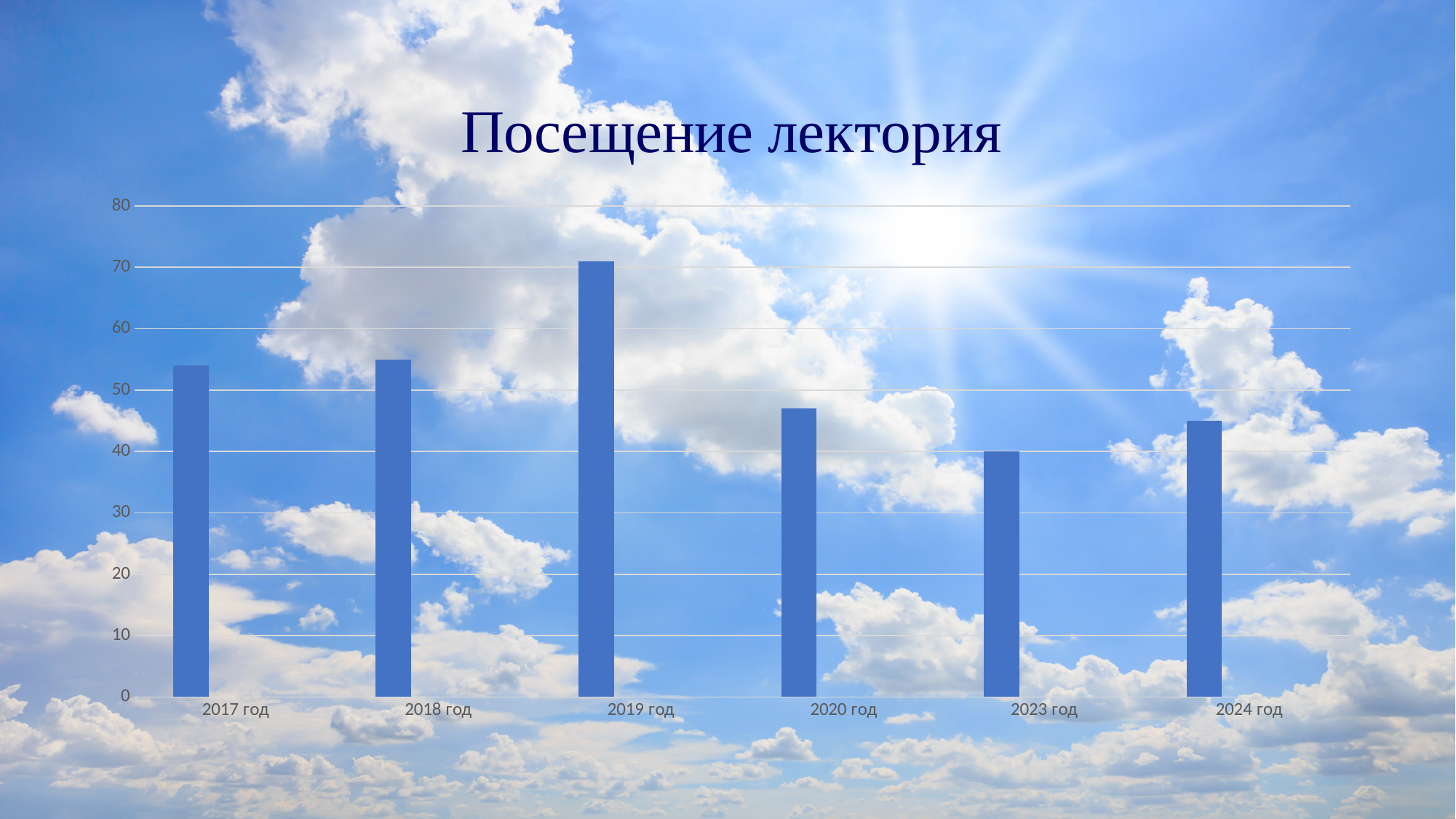
What is the title of the chart? Посещение лектория Is the value for 2017 год greater or less than 50? greater Which is larger, the value for 2019 год or the value for 2020 год? 2019 год How many years are shown on the x axis of the chart? 6 Do the values rise or fall from 2019 год to 2023 год? fall What kind of chart is shown on the slide? bar chart Which year has the lowest value in the chart? 2023 год Is the value for 2024 год greater or less than 50? less Which year has the highest value in the chart? 2019 год Is the value for 2019 год greater or less than 60? greater Which is larger, the value for 2017 год or the value for 2020 год? 2017 год